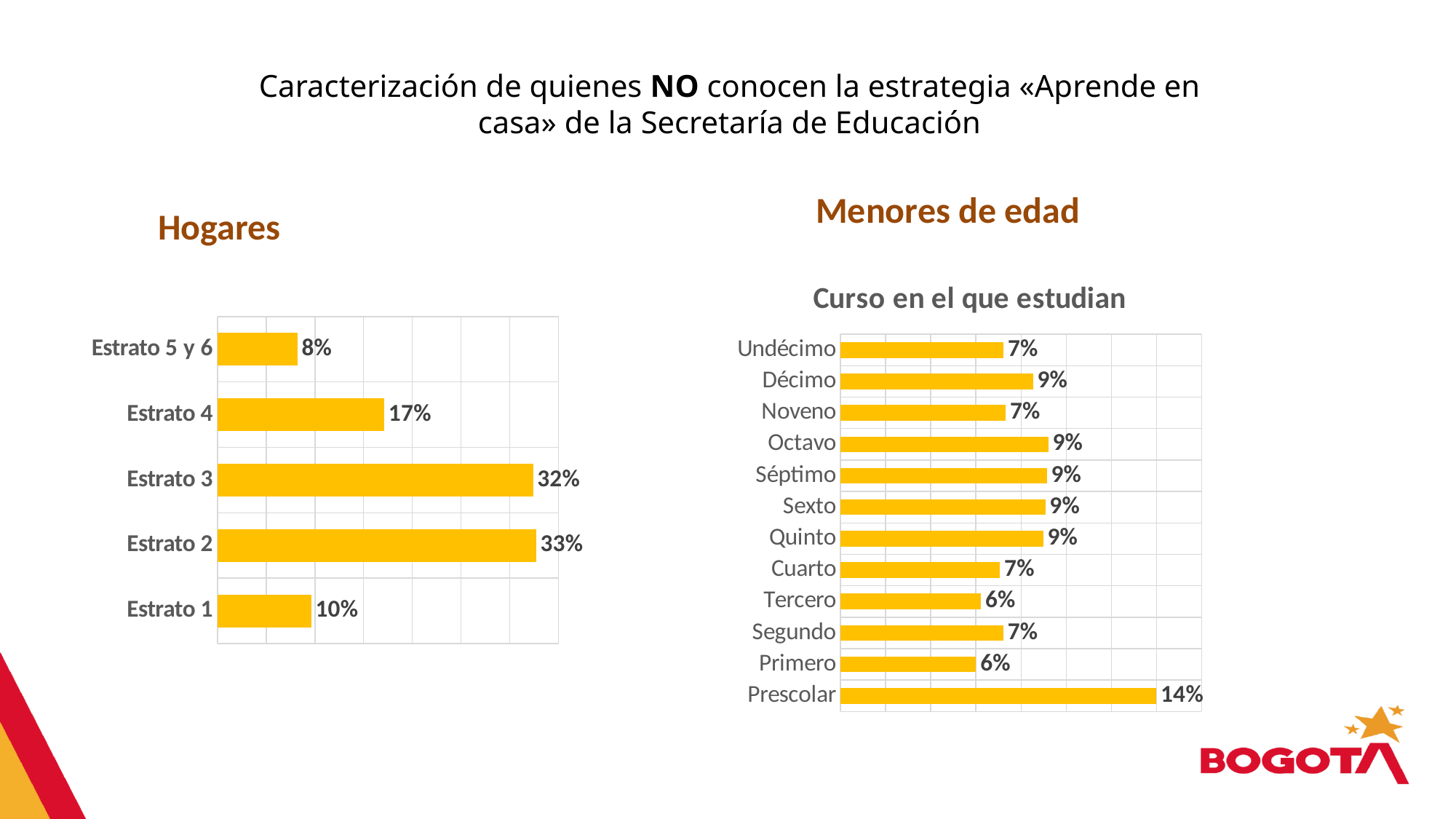
In the Hogares chart on the left, how many categories are shown? 5 In the Hogares chart on the left, which category has the lowest value? Estrato 5 y 6 In the Curso en el que estudian chart on the right, which is larger, the value for Undécimo or the value for Décimo? Décimo In the Hogares chart on the left, what is the value for Estrato 3? 32% In the Curso en el que estudian chart on the right, what is the value for Prescolar? 14% In the Curso en el que estudian chart on the right, how many categories are shown? 12 In the Curso en el que estudian chart on the right, which category has the highest value? Prescolar In the Curso en el que estudian chart on the right, what is the difference between the values for Prescolar and Tercero? 8% What kind of chart is the Hogares chart on the left? Bar chart In the Hogares chart on the left, what is the difference between the values for Estrato 4 and Estrato 1? 7% In the Curso en el que estudian chart on the right, what is the value for Décimo? 9% In the Hogares chart on the left, which category has the highest value? Estrato 2